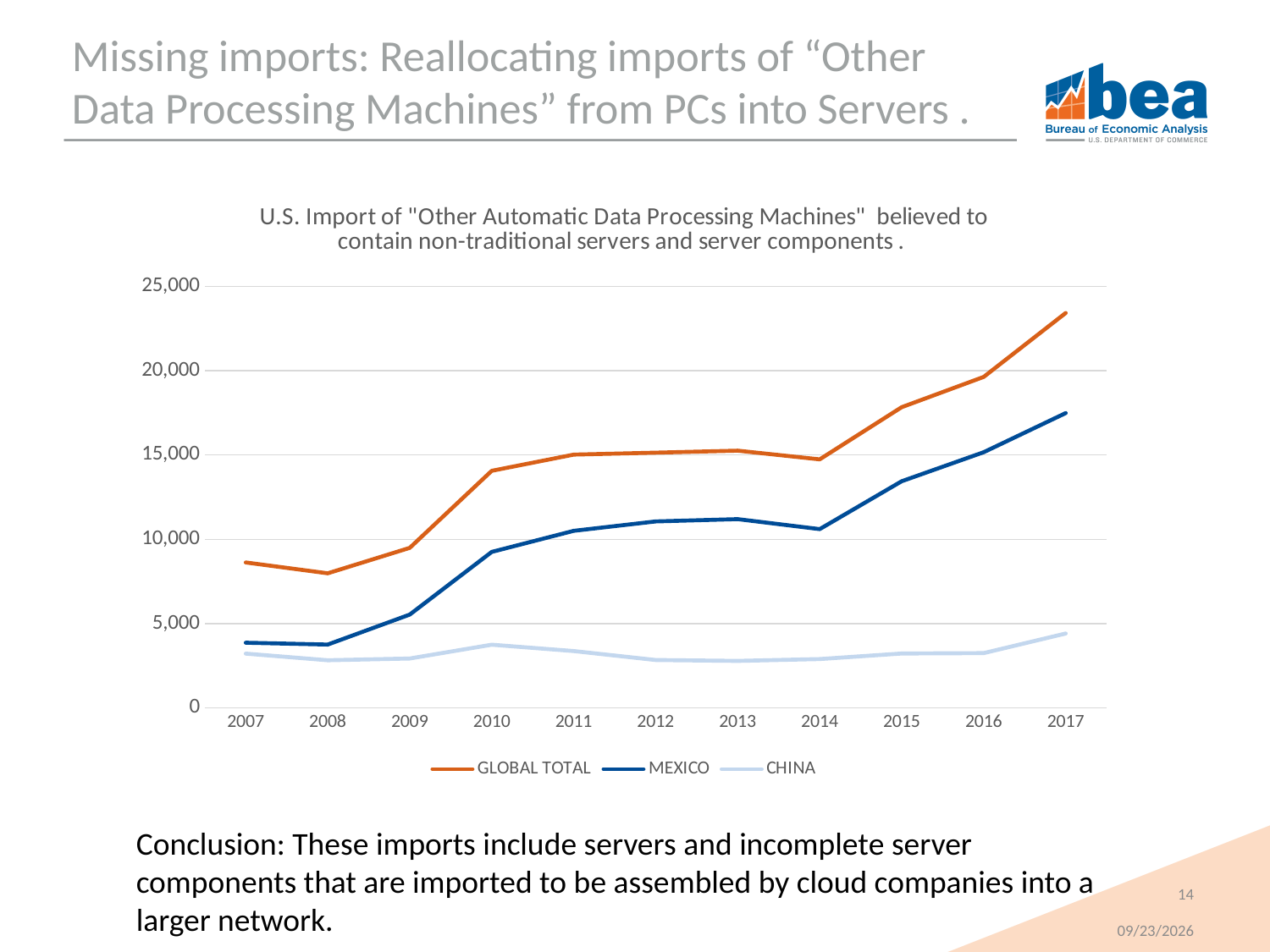
How many series does the legend list? 3 In which year is the GLOBAL TOTAL series at its lowest? 2008 Is the MEXICO value for 2007 greater or less than 5,000? less Is the GLOBAL TOTAL value for 2017 greater or less than 20,000? greater Which series is shown in orange in the legend? GLOBAL TOTAL In which year is the GLOBAL TOTAL series at its highest? 2017 In 2017, which series has the larger value, MEXICO or CHINA? MEXICO Does the GLOBAL TOTAL series rise or fall from 2014 to 2017? rise How many years are plotted along the x axis? 11 In which year is the CHINA series at its highest? 2017 Is the MEXICO value for 2015 greater or less than 10,000? greater What kind of chart is shown on the slide? line chart